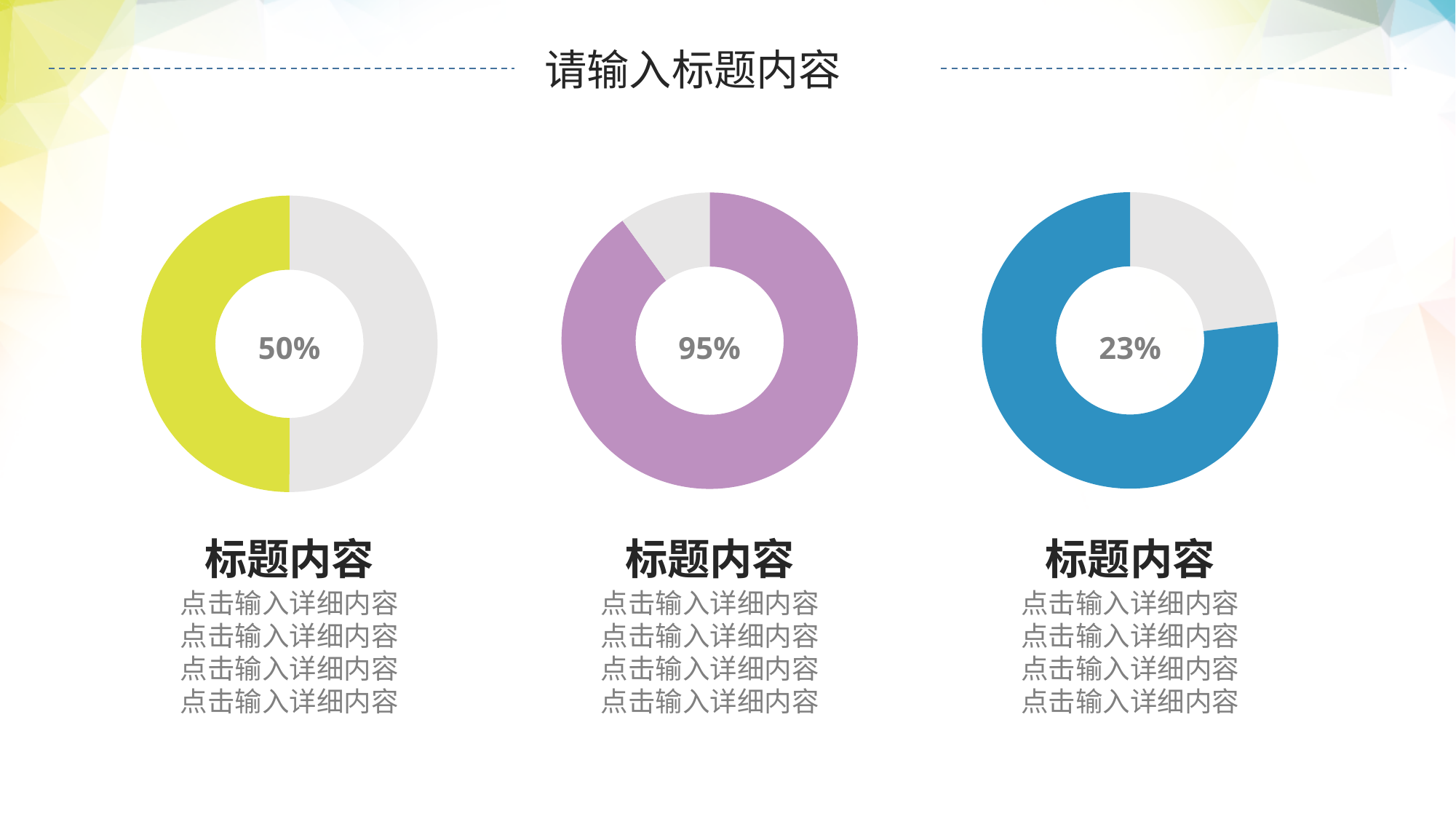
How many doughnut charts are on the slide? 3 What colour is the highlighted segment of the right doughnut chart? Blue What is the difference between the percentage in the left chart and the percentage in the right chart? 27 percentage points Which of the three doughnut charts shows the lowest percentage? The right chart (23%) What percentage is shown in the center of the middle doughnut chart? 95% What is the difference between the percentage in the middle chart and the percentage in the left chart? 45 percentage points What percentage is shown in the center of the right doughnut chart? 23% Which of the three doughnut charts shows the highest percentage? The middle chart (95%) Is the percentage shown in the middle chart greater or less than 90%? greater What percentage is shown in the center of the left doughnut chart? 50% What kind of chart is used on this slide? Doughnut (pie) chart Which shows a larger percentage, the left chart or the right chart? The left chart